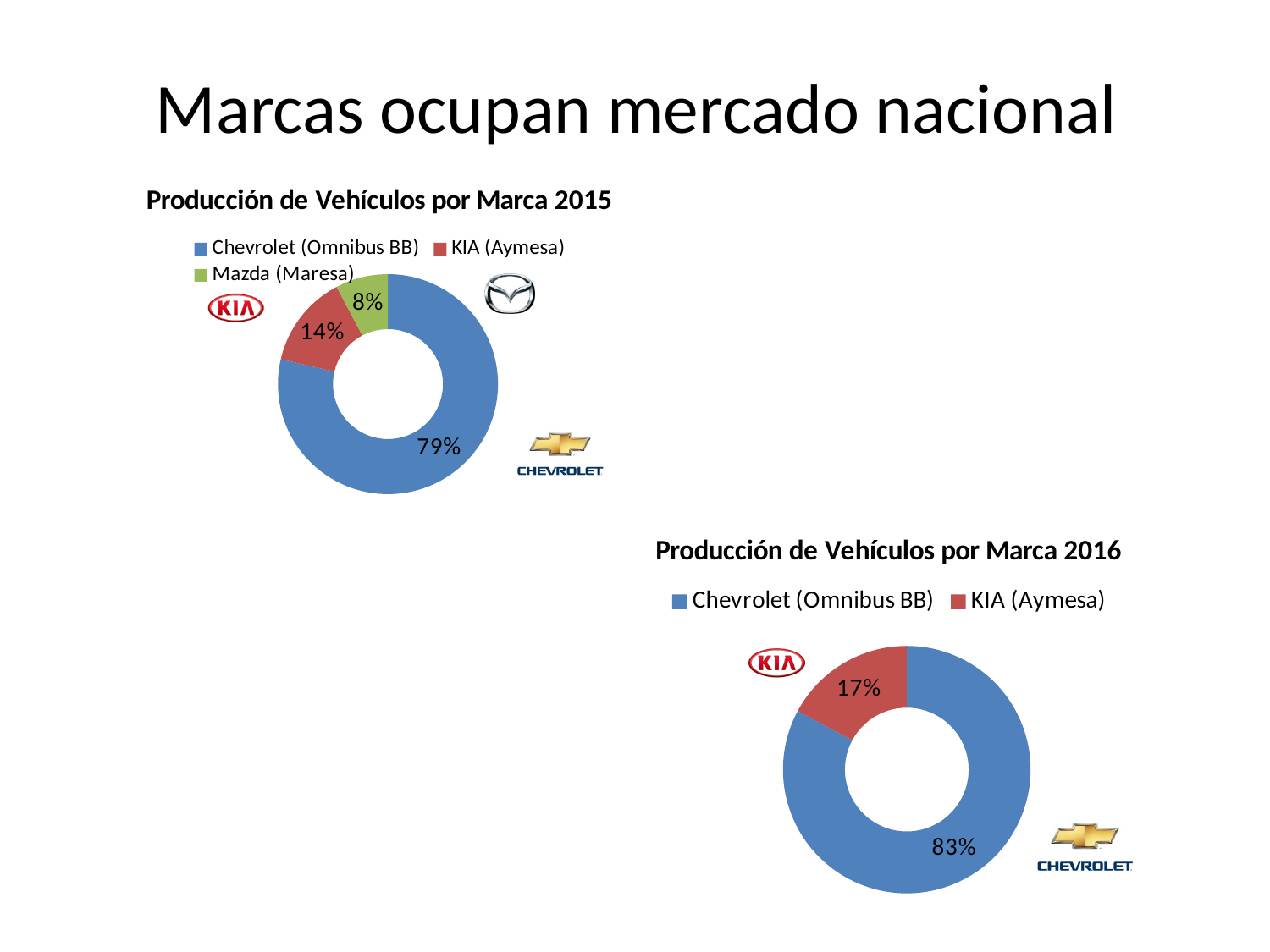
What type of chart is 'Producción de Vehículos por Marca 2016'? Doughnut (pie) chart In the 'Producción de Vehículos por Marca 2015' chart, which brand has the largest share? Chevrolet (Omnibus BB) In the 'Producción de Vehículos por Marca 2016' chart, which brand has the smaller share? KIA (Aymesa) How many brands are shown in the 'Producción de Vehículos por Marca 2016' chart? 2 In the 'Producción de Vehículos por Marca 2015' chart, which brand has the smallest share? Mazda (Maresa) In the 'Producción de Vehículos por Marca 2016' chart, what share does KIA (Aymesa) have? 17% How many entries does the legend of the 'Producción de Vehículos por Marca 2015' chart list? 3 In the 'Producción de Vehículos por Marca 2015' chart, what share does KIA (Aymesa) have? 14% In the 'Producción de Vehículos por Marca 2016' chart, what share does Chevrolet (Omnibus BB) have? 83% In the 'Producción de Vehículos por Marca 2015' chart, what share does Chevrolet (Omnibus BB) have? 79% In the 'Producción de Vehículos por Marca 2015' chart, what is the difference in percentage points between Chevrolet (Omnibus BB) and KIA (Aymesa)? 65 In the 'Producción de Vehículos por Marca 2015' chart, what share does Mazda (Maresa) have? 8%